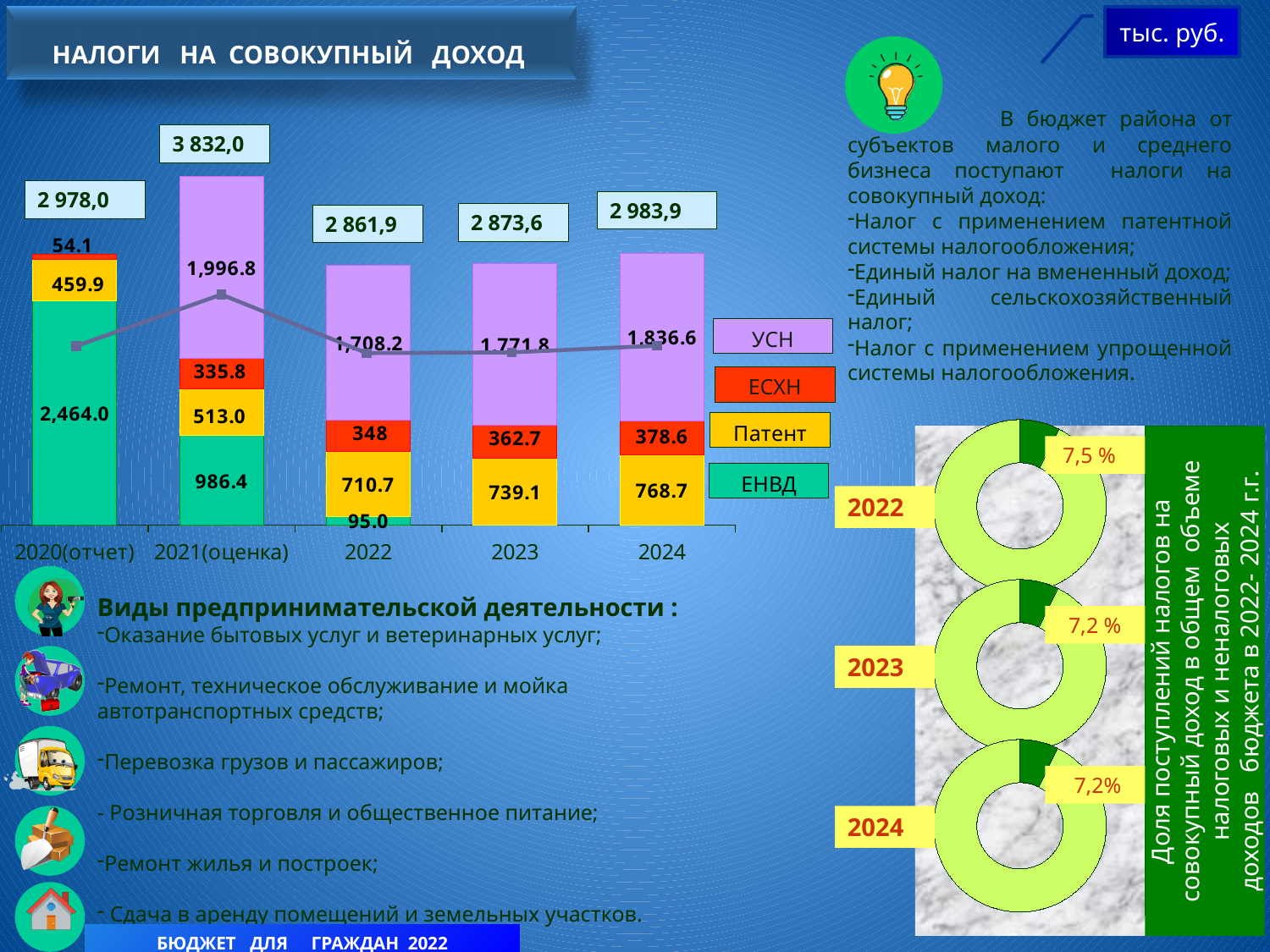
In the stacked bar chart 'НАЛОГИ НА СОВОКУПНЫЙ ДОХОД', what is the difference between the Патент values for 2024 and 2023? 29.6 In the donut charts on the right, what share is shown for 2022? 7,5 % In the stacked bar chart 'НАЛОГИ НА СОВОКУПНЫЙ ДОХОД', what is the ЕСХН value for 2023? 362.7 In the stacked bar chart 'НАЛОГИ НА СОВОКУПНЫЙ ДОХОД', which year has the lowest total? 2022 In the stacked bar chart 'НАЛОГИ НА СОВОКУПНЫЙ ДОХОД', which is larger: the ЕСХН value for 2021(оценка) or for 2022? 2022 In the stacked bar chart 'НАЛОГИ НА СОВОКУПНЫЙ ДОХОД', what is the УСН value for 2021(оценка)? 1,996.8 In the stacked bar chart 'НАЛОГИ НА СОВОКУПНЫЙ ДОХОД', what is the ЕНВД value for 2020(отчет)? 2,464.0 In the stacked bar chart 'НАЛОГИ НА СОВОКУПНЫЙ ДОХОД', how many series does the legend list? 4 In the stacked bar chart 'НАЛОГИ НА СОВОКУПНЫЙ ДОХОД', what is the Патент value for 2024? 768.7 In the stacked bar chart 'НАЛОГИ НА СОВОКУПНЫЙ ДОХОД', what is the total shown above the bar for 2021(оценка)? 3 832,0 In the stacked bar chart 'НАЛОГИ НА СОВОКУПНЫЙ ДОХОД', which year has the highest total? 2021(оценка) In the stacked bar chart 'НАЛОГИ НА СОВОКУПНЫЙ ДОХОД', how many years are shown on the x axis? 5